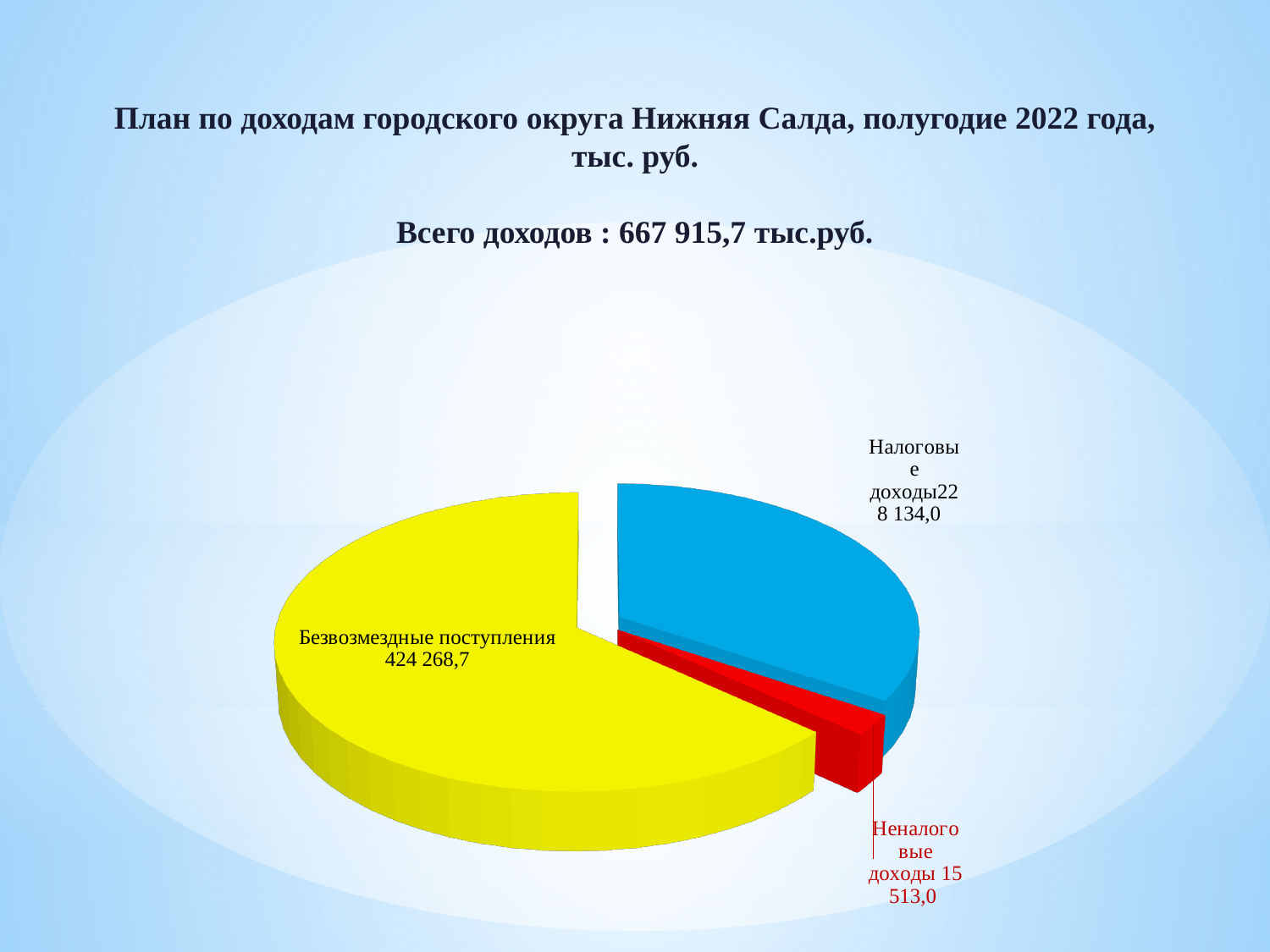
What is the value for Неналоговые доходы? 15 513,0 What is the difference between Безвозмездные поступления and Налоговые доходы? 196 134,7 Which category has the smallest slice of the pie? Неналоговые доходы What is the value for Налоговые доходы? 228 134,0 What colour is the slice for Неналоговые доходы? Red Which is larger, Налоговые доходы or Неналоговые доходы? Налоговые доходы What is the difference between Налоговые доходы and Неналоговые доходы? 212 621,0 What is the value for Безвозмездные поступления? 424 268,7 Which category has the largest slice of the pie? Безвозмездные поступления What total income (Всего доходов) is stated on the slide? 667 915,7 тыс.руб. What type of chart is shown on the slide? Pie chart How many slices does the pie chart have? 3